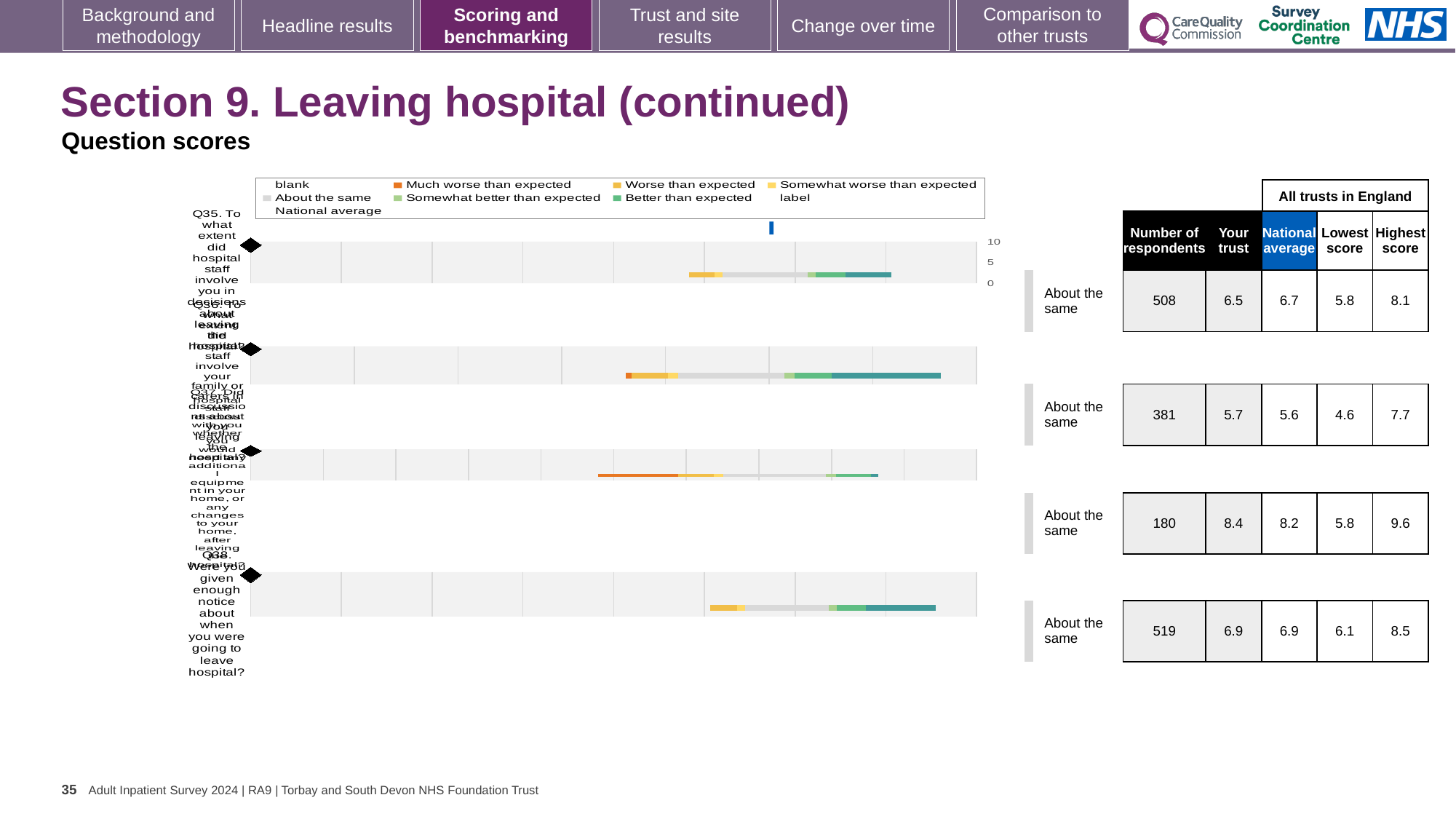
Which question row has the highest 'Your trust' score? the third row (8.4) How many entries does the chart legend list? 9 How many respondents answered Q38 (given enough notice about when you were going to leave hospital)? 519 What kind of chart is shown on the slide? bar chart How many question rows are plotted in the chart? 4 Which question row has the fewest respondents? the third row (180 respondents) For Q35, which is larger: the 'Your trust' score or the national average? national average What is the national average score for Q35? 6.7 What is the 'Your trust' score for Q35 (involving you in decisions about leaving hospital)? 6.5 What is the difference between the highest score and the lowest score for Q35? 2.3 What benchmark category is shown for every question row on the slide? About the same What is the highest score among all trusts in England for Q38? 8.5